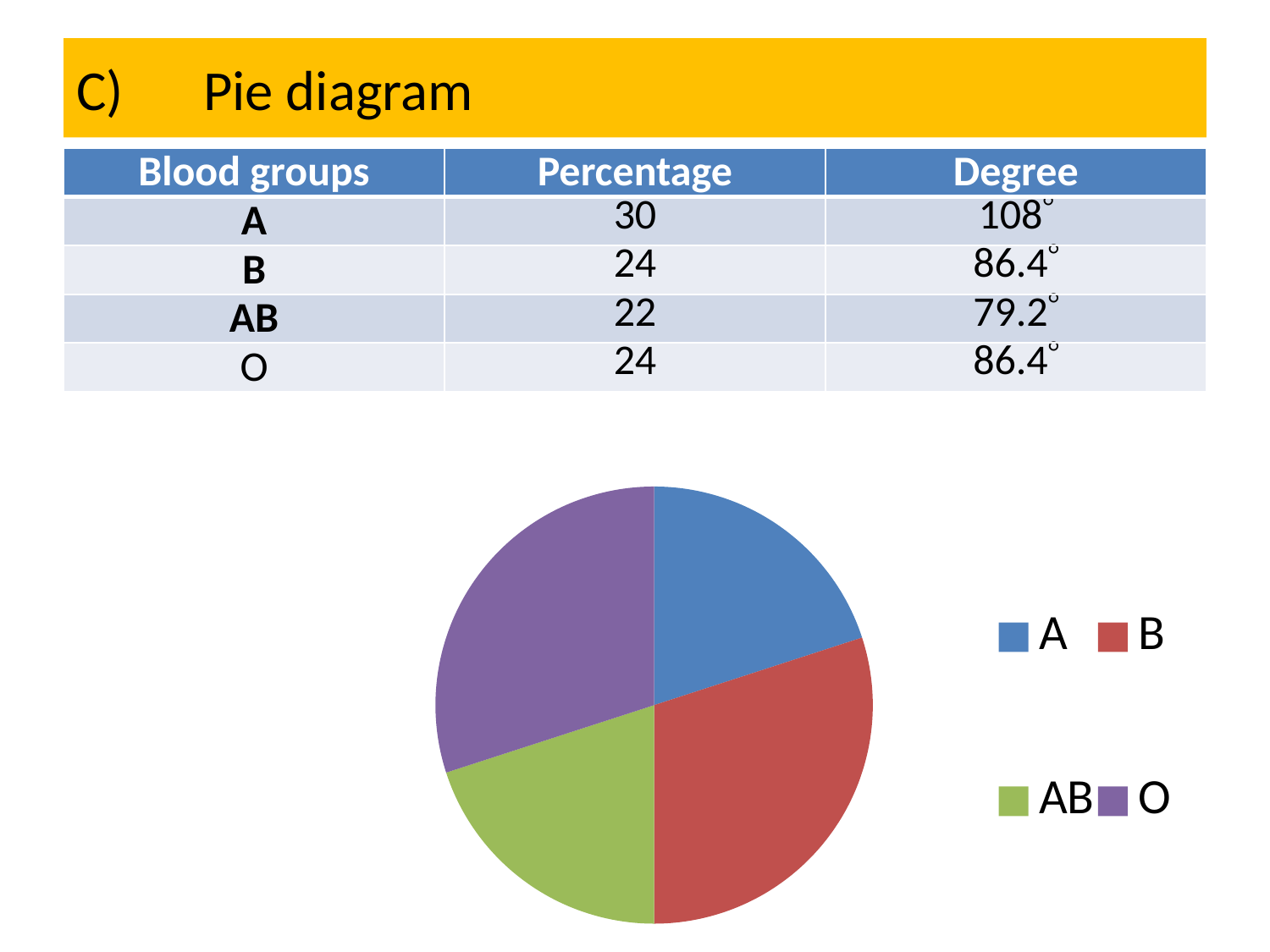
In the pie chart, which slice is larger, A or O? O According to the table on the slide, what is the degree value for blood group AB? 79.2° Which blood groups are listed in the pie chart's legend? A, B, AB, O What kind of chart is shown on the slide? pie chart How many slices does the pie chart have? 4 In the pie chart, which slice is larger, O or AB? O In the pie chart, which slice is larger, AB or B? B According to the table on the slide, what is the percentage for blood group A? 30 How many entries does the pie chart's legend list? 4 What colour is the slice for blood group O in the pie chart? purple